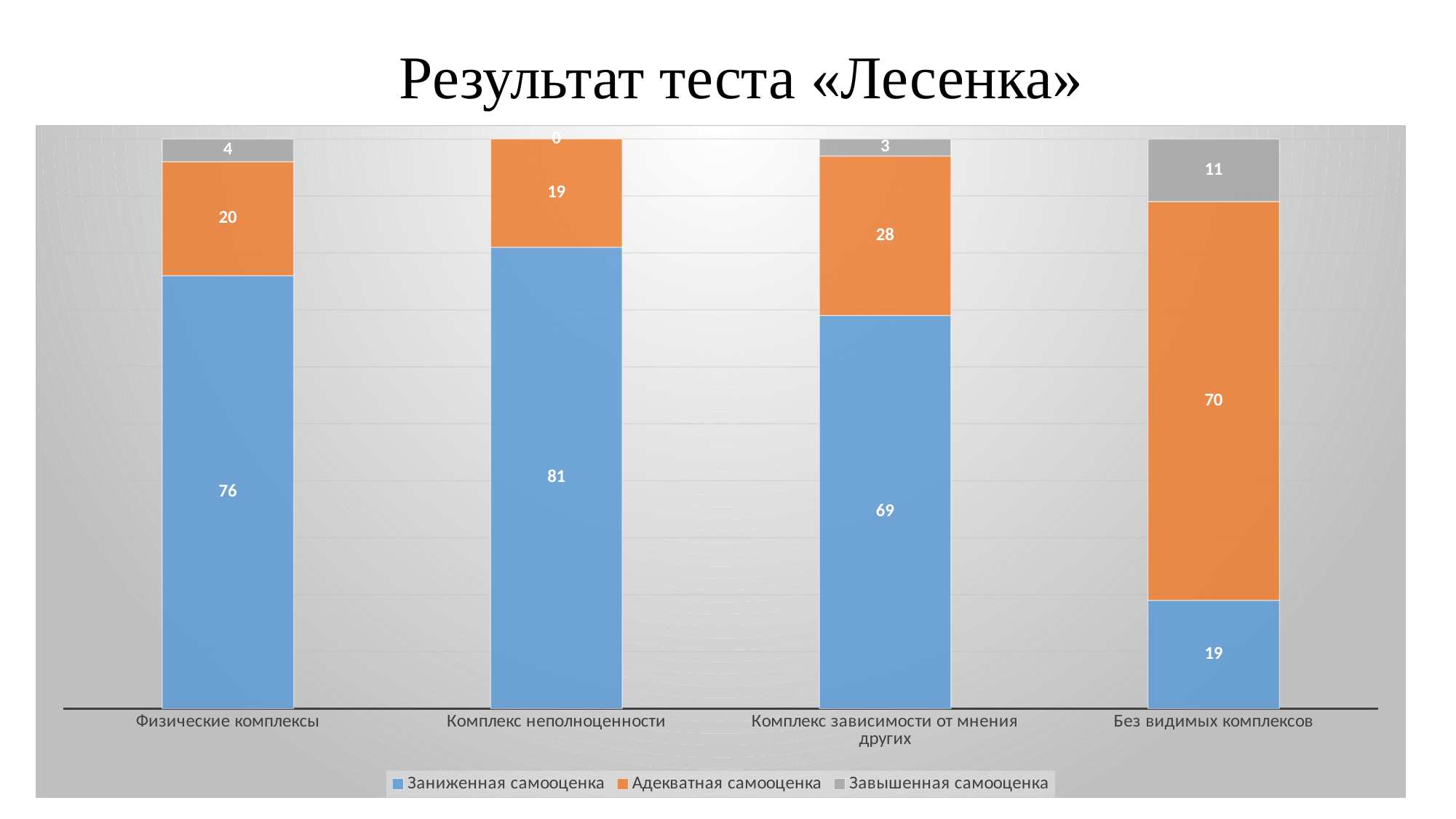
Which is larger: Заниженная самооценка for Физические комплексы or for Комплекс зависимости от мнения других? Физические комплексы What is the value of Заниженная самооценка for Комплекс неполноценности? 81 What is the total of the stacked bar for Без видимых комплексов? 100 What is the value of Завышенная самооценка for Физические комплексы? 4 How many series does the legend list? 3 What is the difference between the Адекватная самооценка values for Без видимых комплексов and Комплекс зависимости от мнения других? 42 What is the title of the chart? Результат теста «Лесенка» Which category has the lowest value for Завышенная самооценка? Комплекс неполноценности How many categories are shown on the x axis? 4 Which category has the highest value for Заниженная самооценка? Комплекс неполноценности What type of chart is shown on the slide? Stacked bar chart What is the value of Адекватная самооценка for Без видимых комплексов? 70